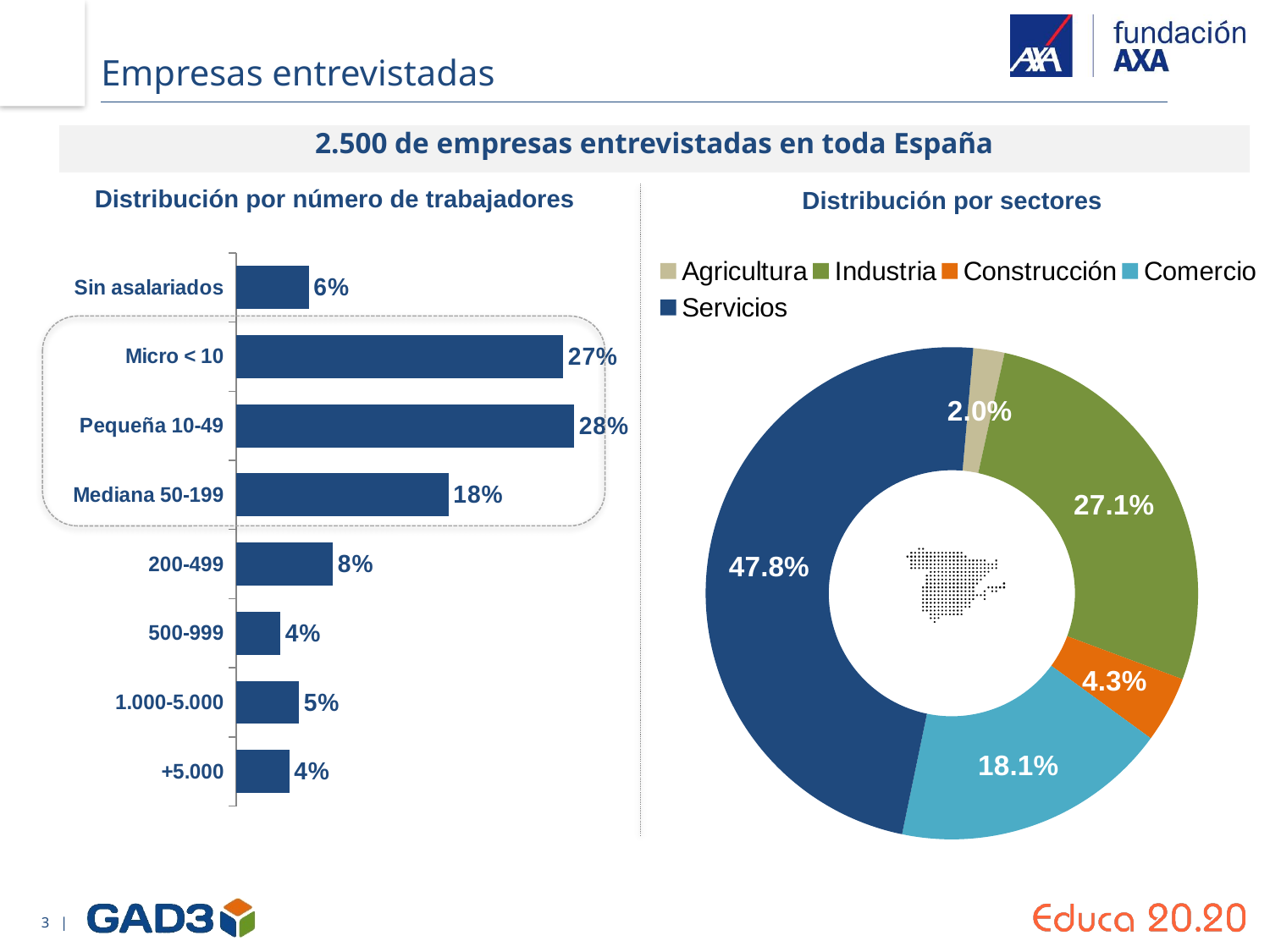
In the 'Distribución por sectores' chart, which sector has the smallest share? Agricultura In the 'Distribución por sectores' chart, what is the difference between Servicios and Construcción? 43.5% How many categories are shown in the 'Distribución por número de trabajadores' chart? 8 How many sectors does the legend of the 'Distribución por sectores' chart list? 5 In the 'Distribución por número de trabajadores' chart, which category has the highest value? Pequeña 10-49 In the 'Distribución por número de trabajadores' chart, what is the difference between Pequeña 10-49 and Mediana 50-199? 10% What kind of chart is 'Distribución por número de trabajadores'? Bar chart In the 'Distribución por sectores' chart, what is the share for Industria? 27.1% In the 'Distribución por sectores' chart, what is the share for Comercio? 18.1% In the 'Distribución por número de trabajadores' chart, what is the value for Mediana 50-199? 18% In the 'Distribución por número de trabajadores' chart, which is larger, Sin asalariados or 200-499? 200-499 In the 'Distribución por número de trabajadores' chart, what is the value for Micro < 10? 27%